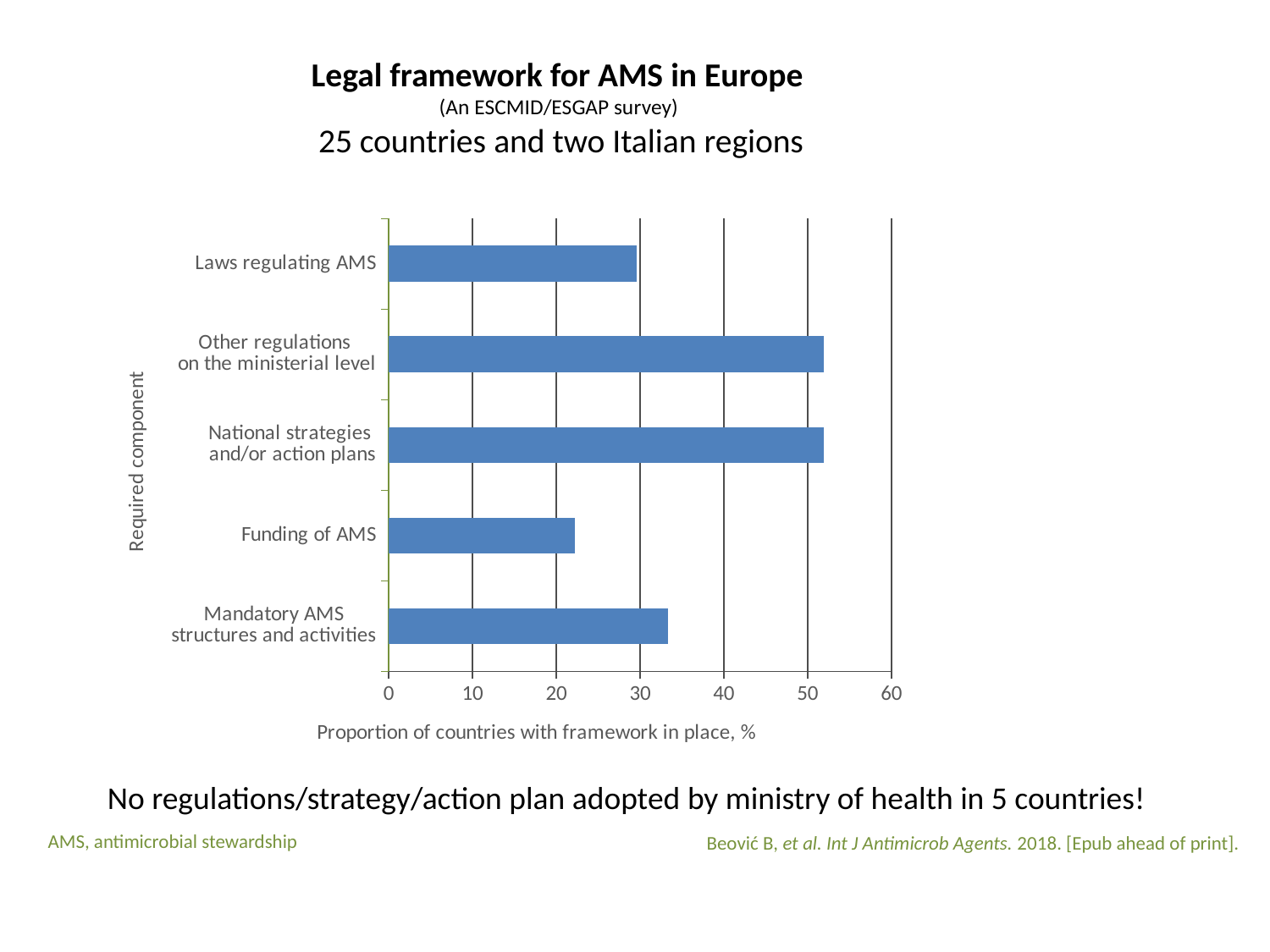
Is the value for Other regulations on the ministerial level greater or less than 50? greater What is the label of the vertical axis of the chart? Required component Is the value for National strategies and/or action plans greater or less than 40? greater Which is larger, the value for Laws regulating AMS or the value for Funding of AMS? Laws regulating AMS Is the value for Mandatory AMS structures and activities greater or less than 40? less How many required components are plotted in the chart? 5 What is the label of the horizontal axis of the chart? Proportion of countries with framework in place, % Which is larger, the value for Mandatory AMS structures and activities or the value for National strategies and/or action plans? National strategies and/or action plans Which required component has the lowest proportion of countries with a framework in place? Funding of AMS What kind of chart is shown on the slide? bar chart